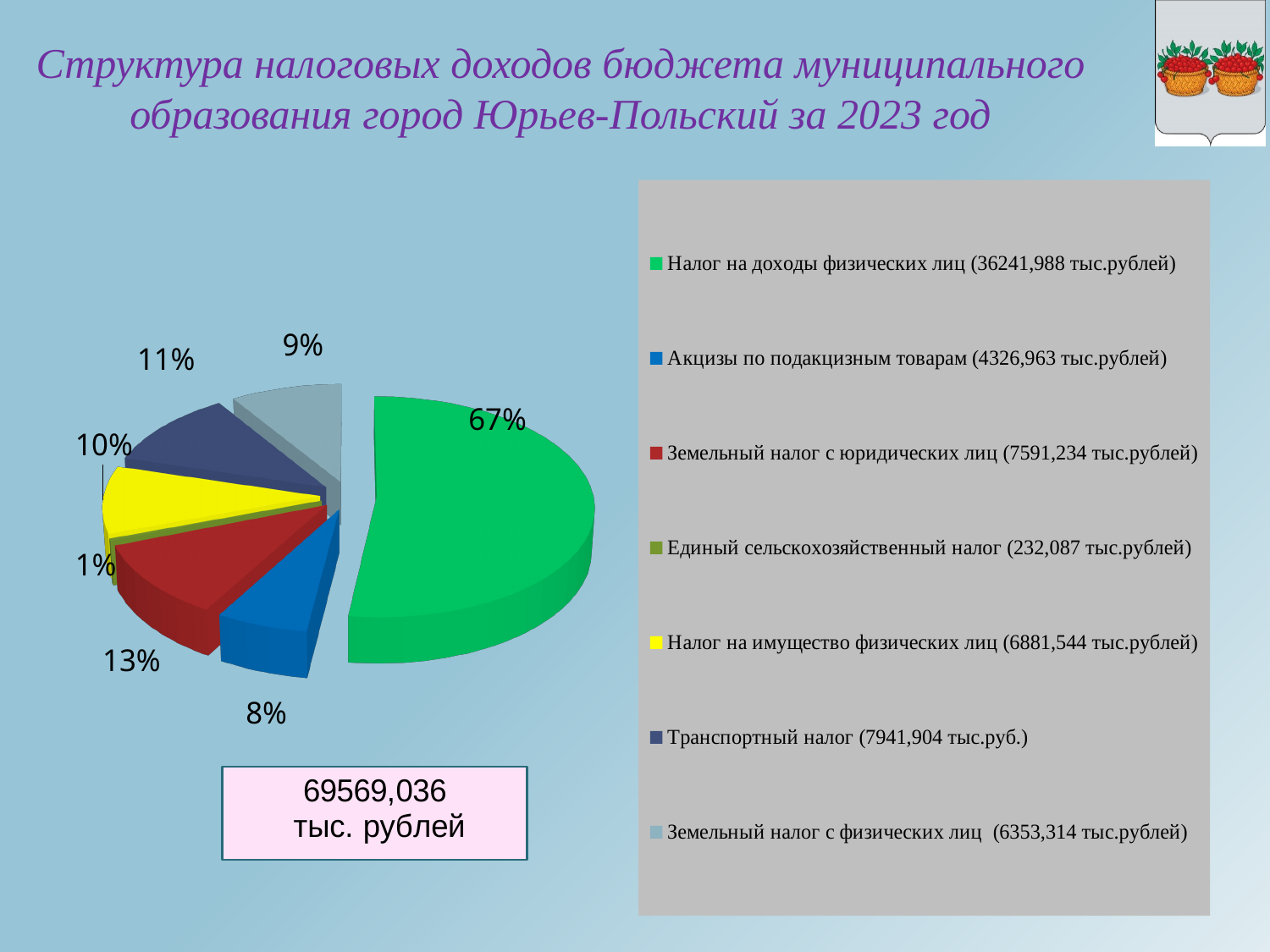
What is the difference in percentage points between the share for Земельный налог с юридических лиц (13%) and Акцизы по подакцизным товарам (8%)? 5 percentage points According to the legend, what is the amount for Акцизы по подакцизным товарам? 4326,963 тыс.рублей Which tax has the largest share of the pie? Налог на доходы физических лиц According to the legend, what is the amount for Транспортный налог? 7941,904 тыс.руб. What type of chart is shown on the slide? Pie chart Which is larger: the share for Транспортный налог or the share for Земельный налог с физических лиц? Транспортный налог What percentage share is shown for Налог на доходы физических лиц (the green slice)? 67% Which tax has the smallest share of the pie? Единый сельскохозяйственный налог What total amount of tax revenue is shown in the box below the pie chart? 69569,036 тыс. рублей How many slices does the pie chart have? 7 What percentage share is shown for Земельный налог с юридических лиц (the red slice)? 13% What percentage share is shown for Единый сельскохозяйственный налог? 1%